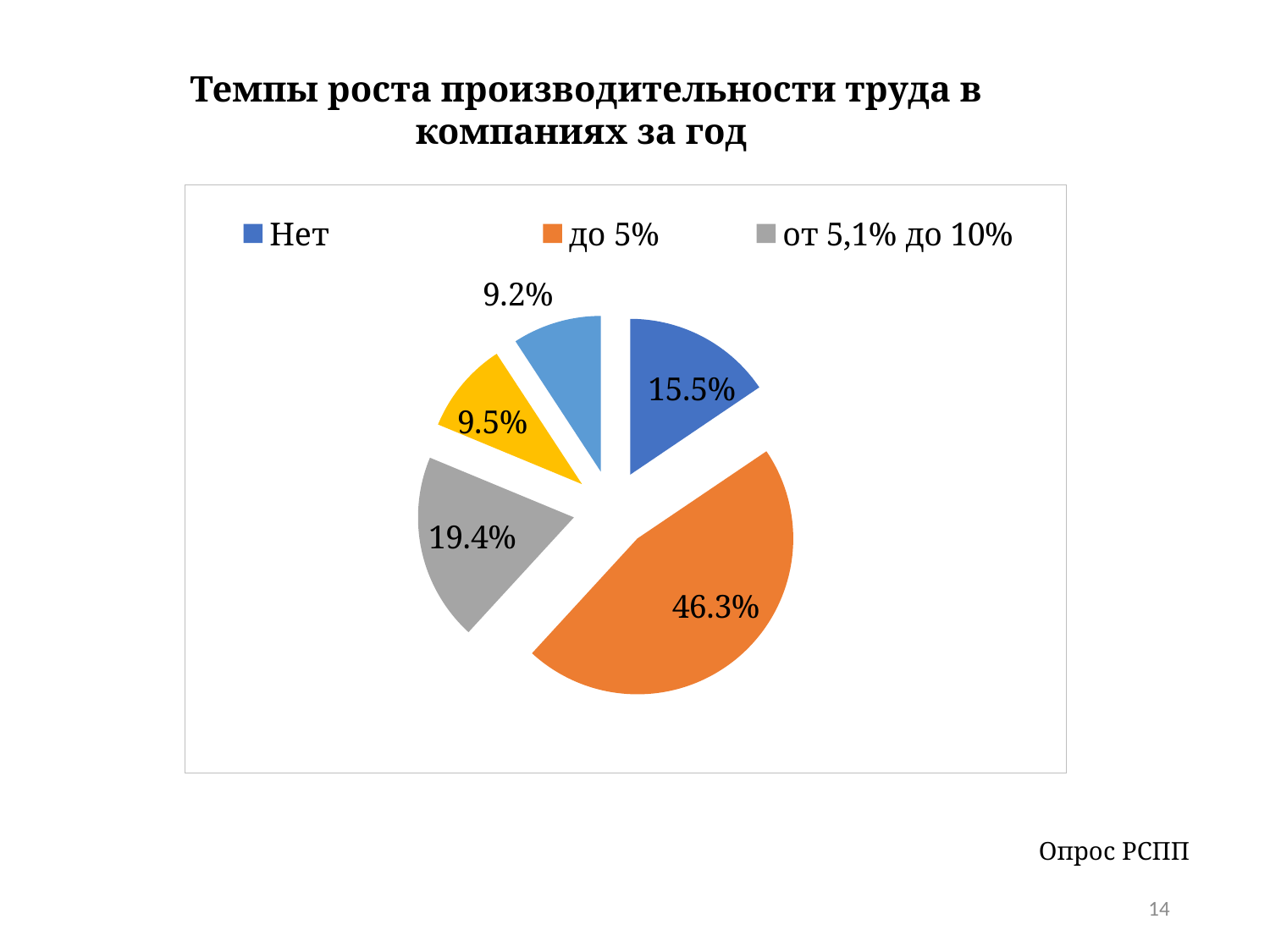
What is the value of the "Нет" slice? 15.5% By how many percentage points is the "до 5%" slice larger than the "Нет" slice? 30.8 What is the value of the "до 5%" slice? 46.3% How many entries does the legend list? 3 What kind of chart is shown on the slide? pie chart Which category has the largest slice of the pie? до 5% By how many percentage points is the "от 5,1% до 10%" slice larger than the "Нет" slice? 3.9 What is the value of the yellow slice? 9.5% Which is larger, the "Нет" slice or the "от 5,1% до 10%" slice? от 5,1% до 10% How many slices does the pie chart have? 5 What is the value of the "от 5,1% до 10%" slice? 19.4% What is the value of the smallest slice of the pie? 9.2%